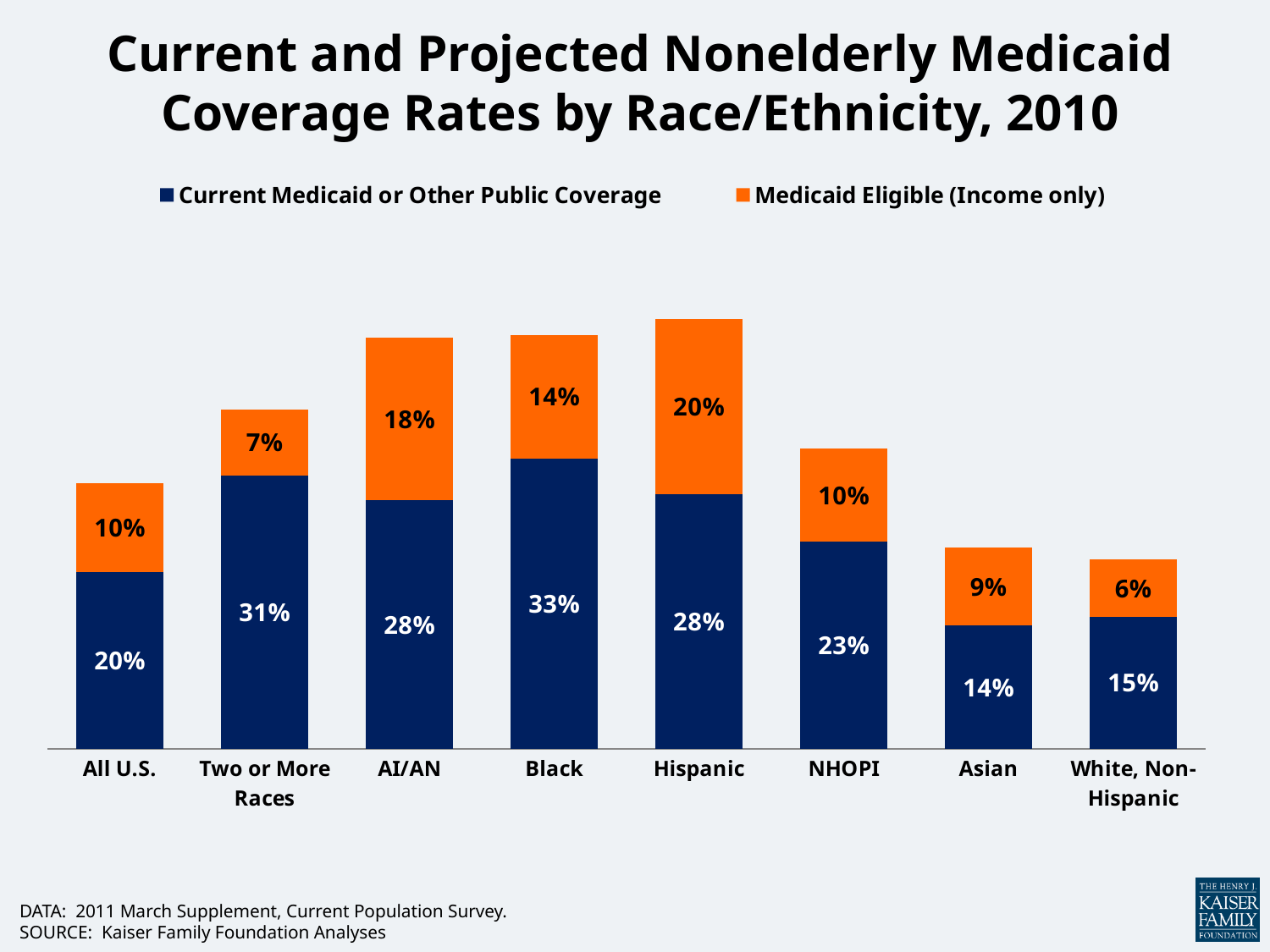
What is the Medicaid Eligible (Income only) value for AI/AN? 18% What is the Current Medicaid or Other Public Coverage value for Asian? 14% Which category has the highest Current Medicaid or Other Public Coverage value? Black What is the total of the stacked bar for Black? 47% Which colour represents Medicaid Eligible (Income only) in the legend? Orange What is the Current Medicaid or Other Public Coverage value for Hispanic? 28% What is the difference between the Medicaid Eligible (Income only) values for Hispanic and NHOPI? 10% What kind of chart is shown on the slide? Stacked bar chart Which is larger: the Current Medicaid or Other Public Coverage value for Two or More Races or for NHOPI? Two or More Races How many race/ethnicity categories are shown on the x axis? 8 How many series does the legend list? 2 Which category has the lowest Medicaid Eligible (Income only) value? White, Non-Hispanic